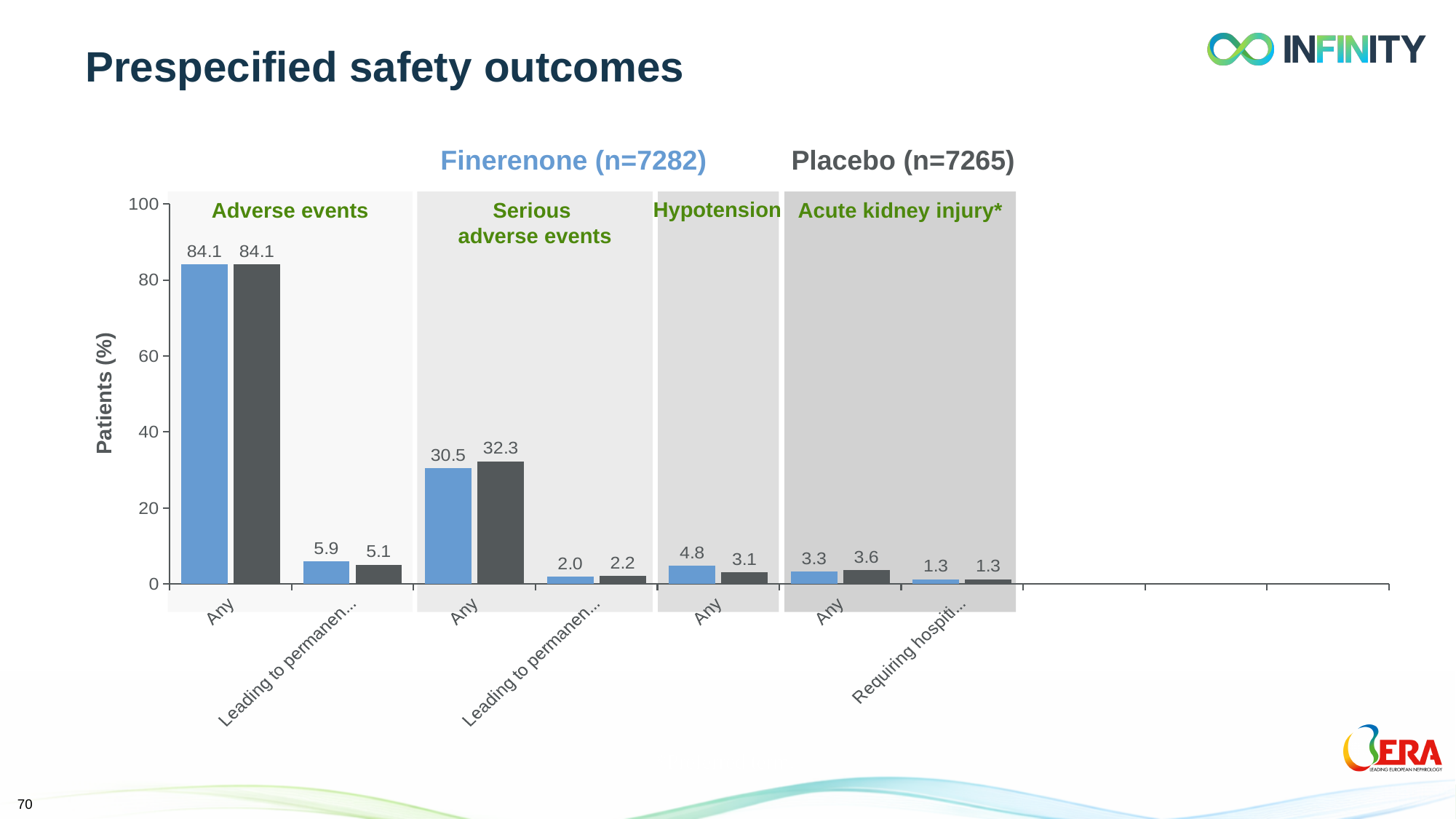
What is the difference between the Placebo and Finerenone values for 'Any' serious adverse events? 1.8 What is the Placebo value for 'Any' serious adverse events? 32.3 What is the label of the y axis? Patients (%) Which group has the highest Finerenone value? Any (Adverse events) How many series does the chart show? 2 What kind of chart is shown on the slide? Bar chart What is the Finerenone value for 'Any' hypotension? 4.8 For 'Any' serious adverse events, which is larger: the Finerenone value or the Placebo value? Placebo For 'Any' hypotension, which is larger: the Finerenone value or the Placebo value? Finerenone What is the difference between the Finerenone and Placebo values for 'Any' hypotension? 1.7 What is the Finerenone value for 'Any' adverse events? 84.1 What is the Placebo value for 'Any' acute kidney injury? 3.6